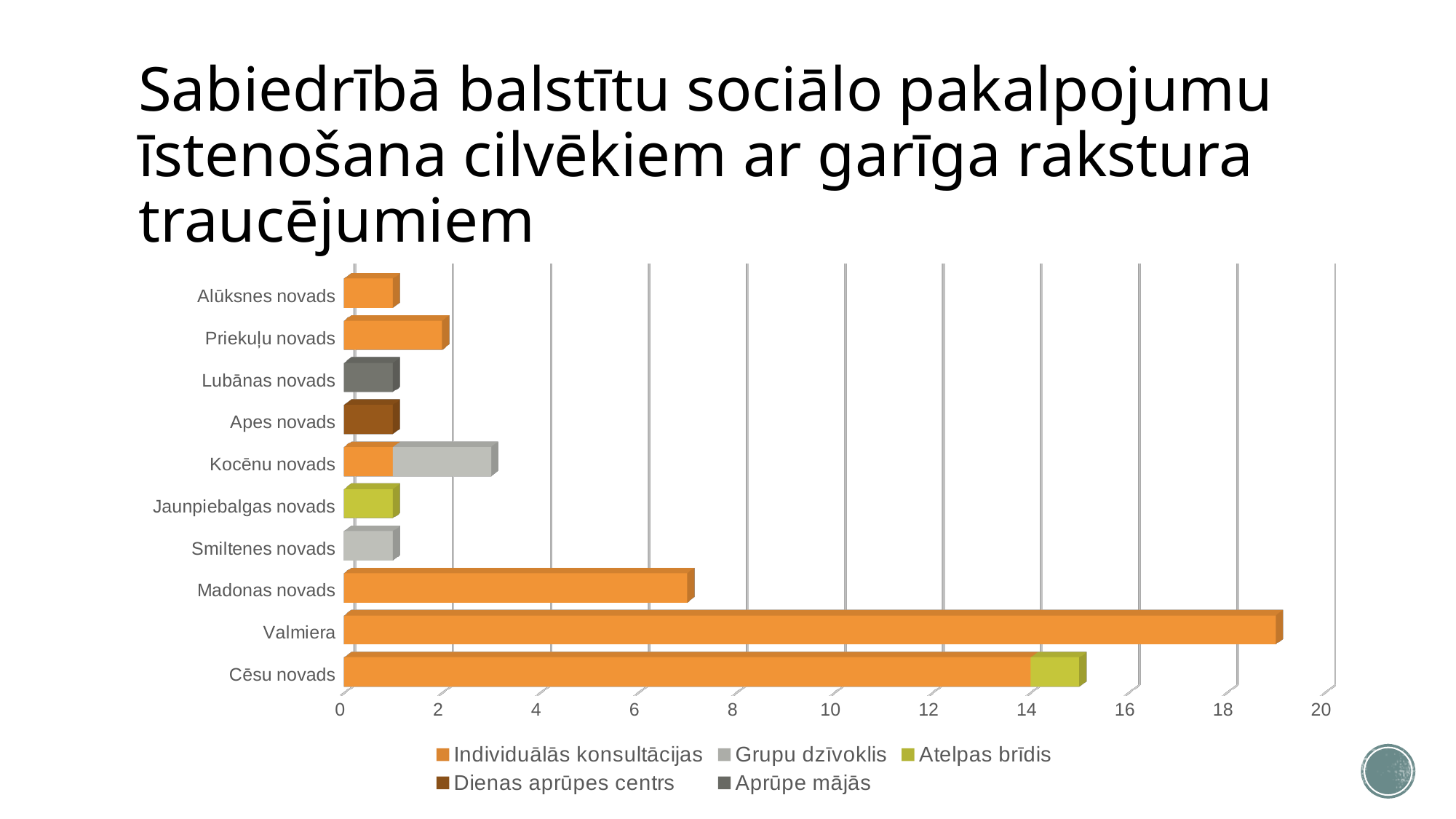
Is the value for Madonas novads greater or less than 6? greater How many series does the chart legend list? 5 Which category has the longest bar in the chart? Valmiera Which has a larger value, Madonas novads or Priekuļu novads? Madonas novads What is the value of Individuālās konsultācijas for Priekuļu novads? 2 What kind of chart is shown on the slide? bar chart How many categories (novads/cities) are listed on the vertical axis of the chart? 10 Which series is shown for Apes novads? Dienas aprūpes centrs Which series is shown for Lubānas novads? Aprūpe mājās Which has a larger total bar, Valmiera or Cēsu novads? Valmiera Is the value for Valmiera greater or less than 18? greater Is the value for Madonas novads greater or less than 8? less